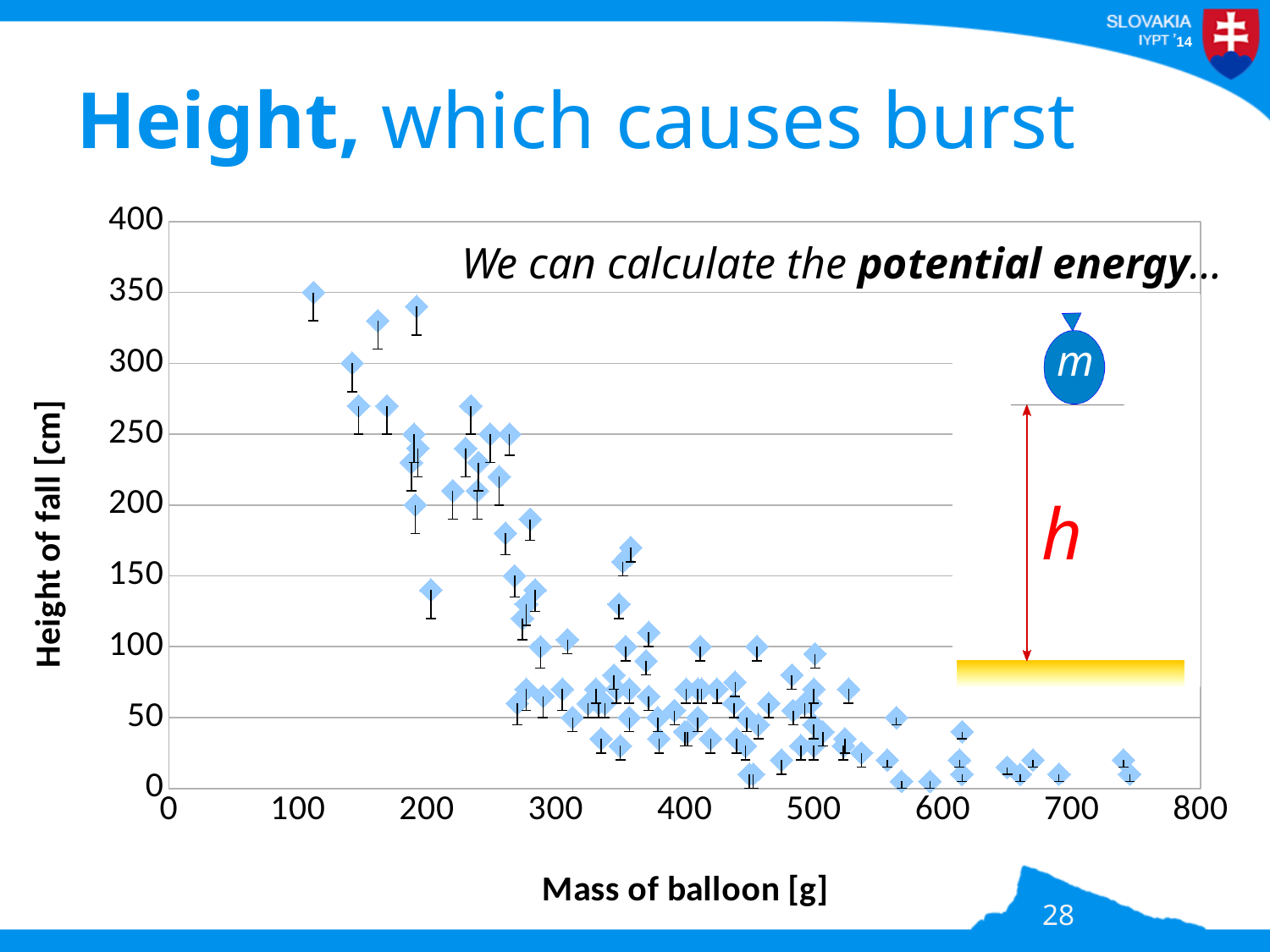
What is the label of the x axis? Mass of balloon [g] Is the highest plotted height of fall found at the low-mass end or the high-mass end of the x axis? low-mass end As the mass of the balloon increases along the x axis, does the height of fall generally rise or fall? fall Is the height of fall for the balloon of about 110 g greater or less than 300? greater Is the height of fall for the balloons of about 750 g greater or less than 50? less Is the highest point plotted near 350 g greater or less than 150? greater Is the height of fall for balloons of about 100 g larger or smaller than for balloons of about 700 g? larger What kind of chart is shown on the slide? scatter plot What is the label of the y axis? Height of fall [cm]